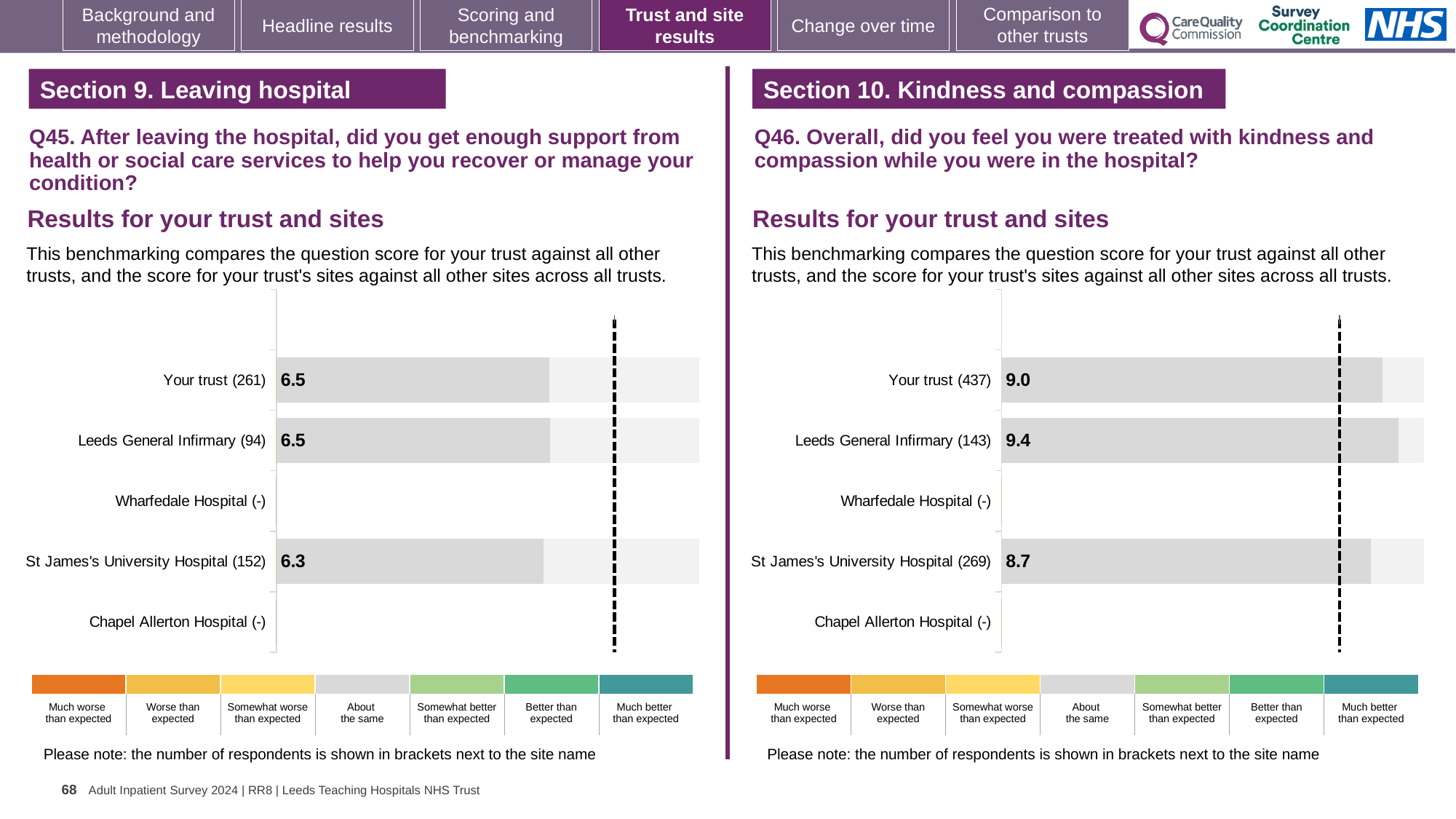
In the Q45 chart on the left, what is the score for St James's University Hospital? 6.3 In the Q45 chart on the left, how many respondents are shown in brackets for Your trust? 261 In the Q45 chart on the left, what is the score for Your trust? 6.5 In the Q46 chart on the right, which site or trust row has the highest score? Leeds General Infirmary How many rows (trust and sites) are listed in the Q45 chart on the left? 5 In the Q46 chart on the right, which is larger: the score for Your trust or the score for St James's University Hospital? Your trust What kind of chart is used for the Q46 results on the right? Bar chart In the Q46 chart on the right, which row with a score has the lowest score? St James's University Hospital In the Q45 chart on the left, what is the difference between the scores for Your trust and St James's University Hospital? 0.2 In the Q46 chart on the right, what is the score for St James's University Hospital? 8.7 In the Q46 chart on the right, what is the difference between the scores for Leeds General Infirmary and St James's University Hospital? 0.7 In the Q46 chart on the right, what is the score for Leeds General Infirmary? 9.4